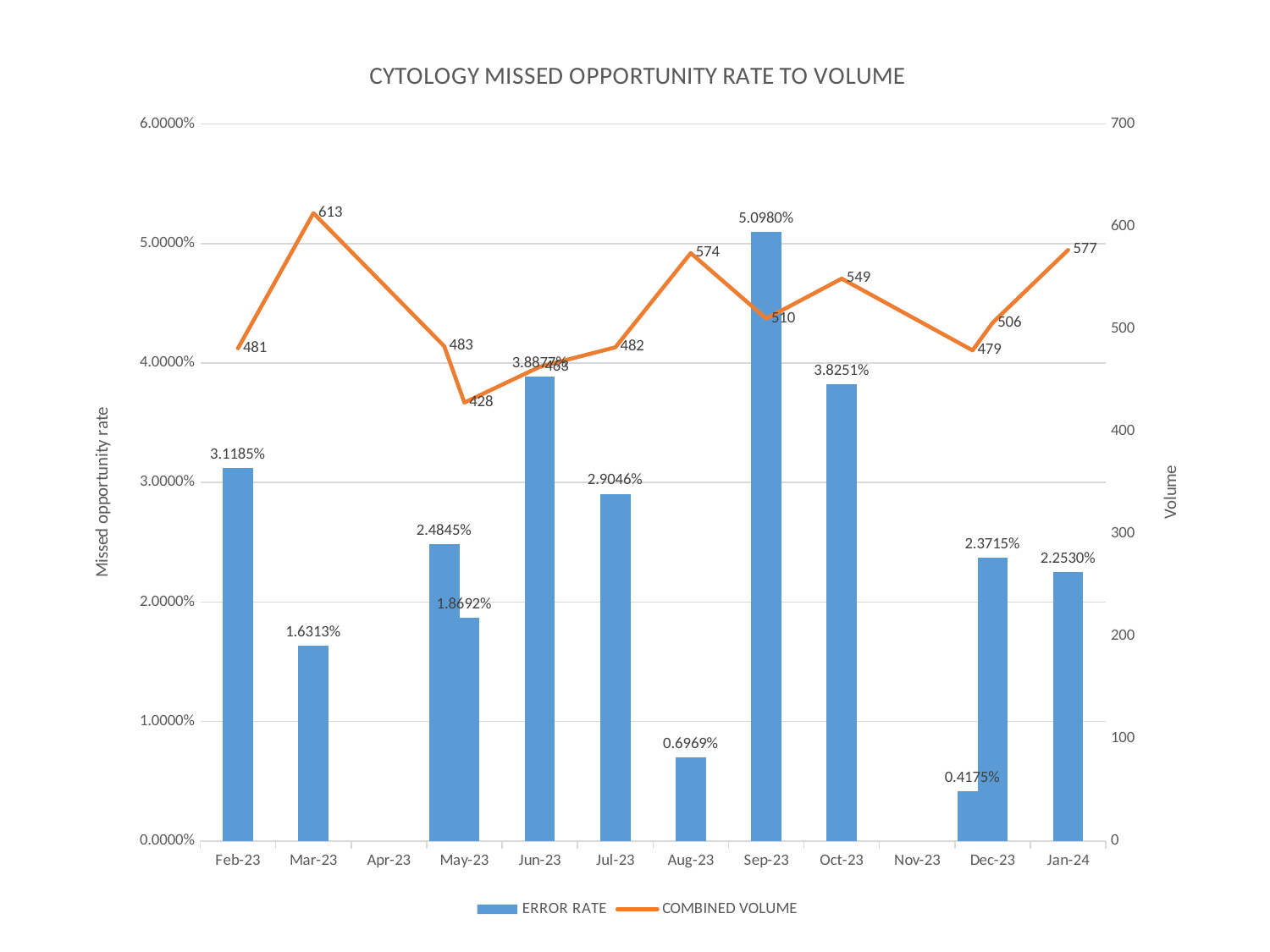
What is the combined volume for Jan-24? 577 What is the error rate for Feb-23? 3.1185% What kind of chart is this? Combination bar and line chart What is the title of the chart? CYTOLOGY MISSED OPPORTUNITY RATE TO VOLUME What is the combined volume for Mar-23? 613 What is the error rate for Sep-23? 5.0980% Which month has the highest error rate? Sep-23 How many series does the legend list? 2 What is the error rate for Aug-23? 0.6969% Which month has the highest combined volume? Mar-23 Which is larger, the error rate for Oct-23 or the error rate for Jul-23? Oct-23 What is the difference between the error rate for Sep-23 and the error rate for Feb-23? 1.9795%